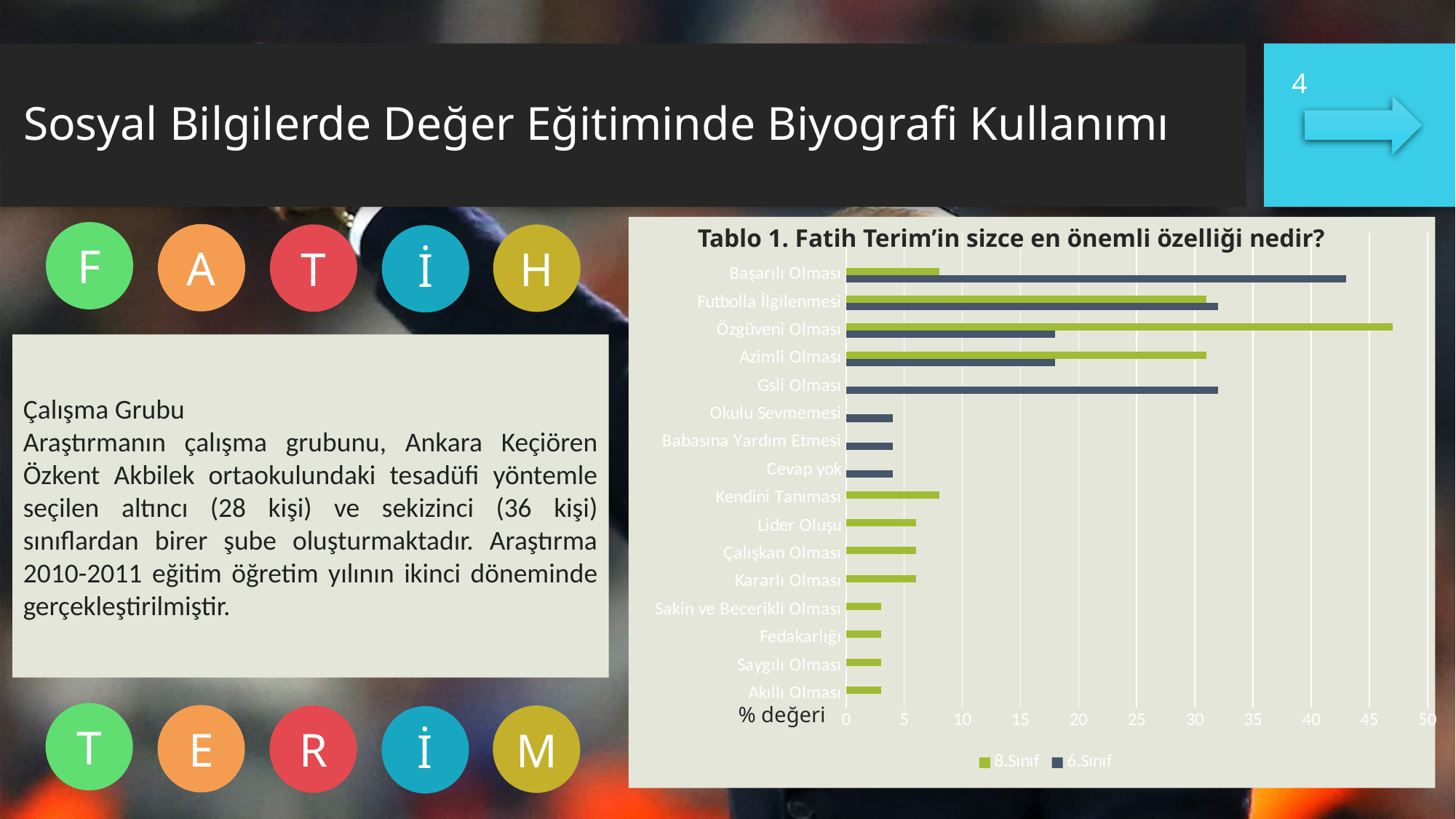
Is the 6.Sınıf value for Başarılı Olması greater or less than 40? greater For Özgüveni Olması, which series has the larger value, 8.Sınıf or 6.Sınıf? 8.Sınıf What is the title of the chart? Tablo 1. Fatih Terim'in sizce en önemli özelliği nedir? How many series does the chart legend list? 2 Which category has the highest value for the 6.Sınıf series? Başarılı Olması Is the 6.Sınıf value for Okulu Sevmemesi greater or less than 5? less Which category has the highest value for the 8.Sınıf series? Özgüveni Olması What kind of chart is shown on the slide? bar chart Is the 8.Sınıf value for Özgüveni Olması greater or less than 40? greater For Başarılı Olması, which series has the larger value, 8.Sınıf or 6.Sınıf? 6.Sınıf How many categories are plotted on the chart? 16